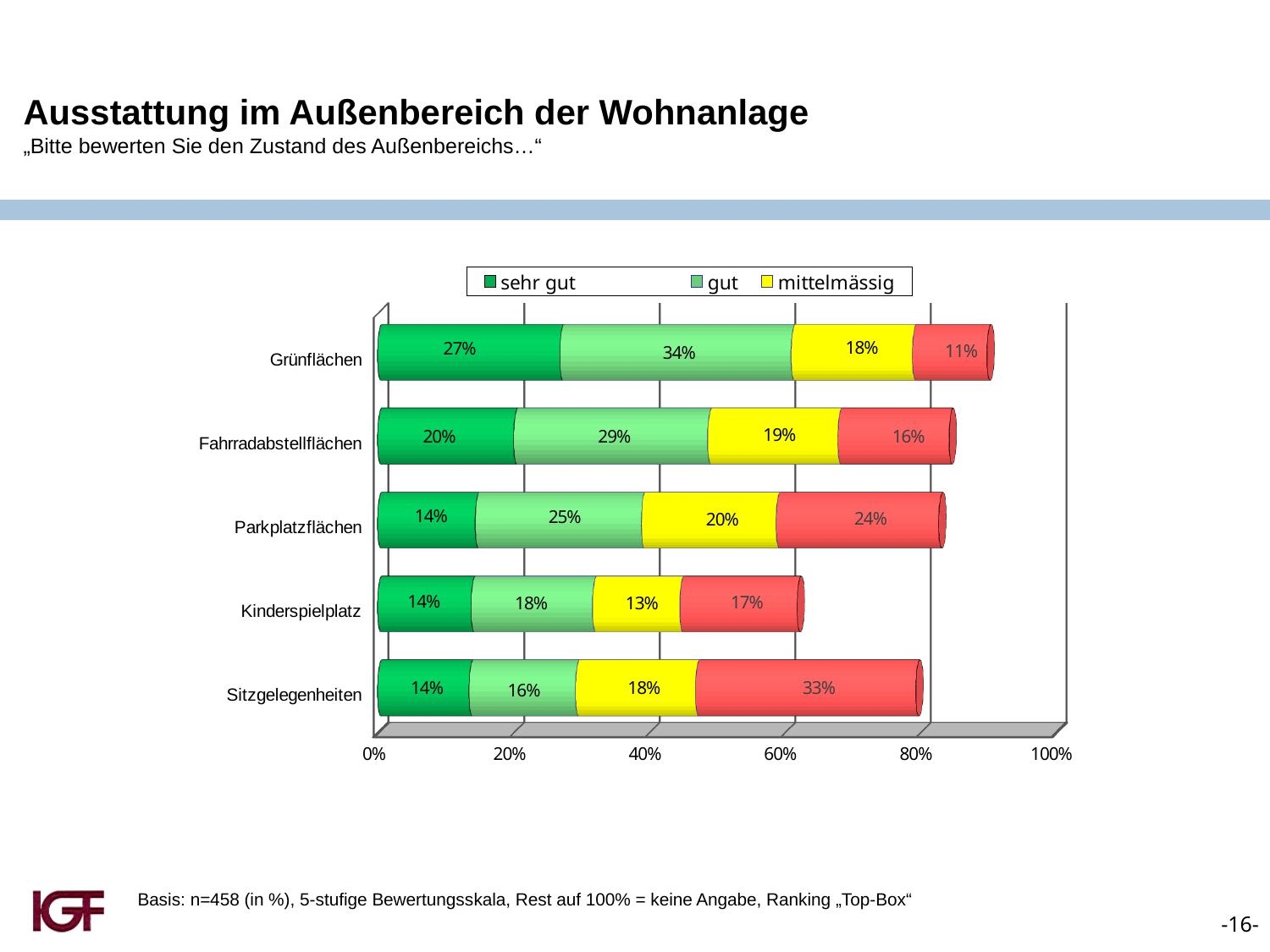
What is the title of the slide containing the chart? Ausstattung im Außenbereich der Wohnanlage What is the difference between the "gut" values for Grünflächen and Kinderspielplatz? 16% Which is larger: the "mittelmässig" value for Fahrradabstellflächen or for Kinderspielplatz? Fahrradabstellflächen What kind of chart is shown on the slide? Stacked bar chart How many series does the legend list? 3 What is the "mittelmässig" value for Parkplatzflächen? 20% Which category has the highest "sehr gut" value? Grünflächen What is the "gut" value for Fahrradabstellflächen? 29% How many categories are shown on the chart? 5 What is the total of the stacked bar for Kinderspielplatz? 62% Which category has the lowest "gut" value? Sitzgelegenheiten What is the "sehr gut" value for Grünflächen? 27%